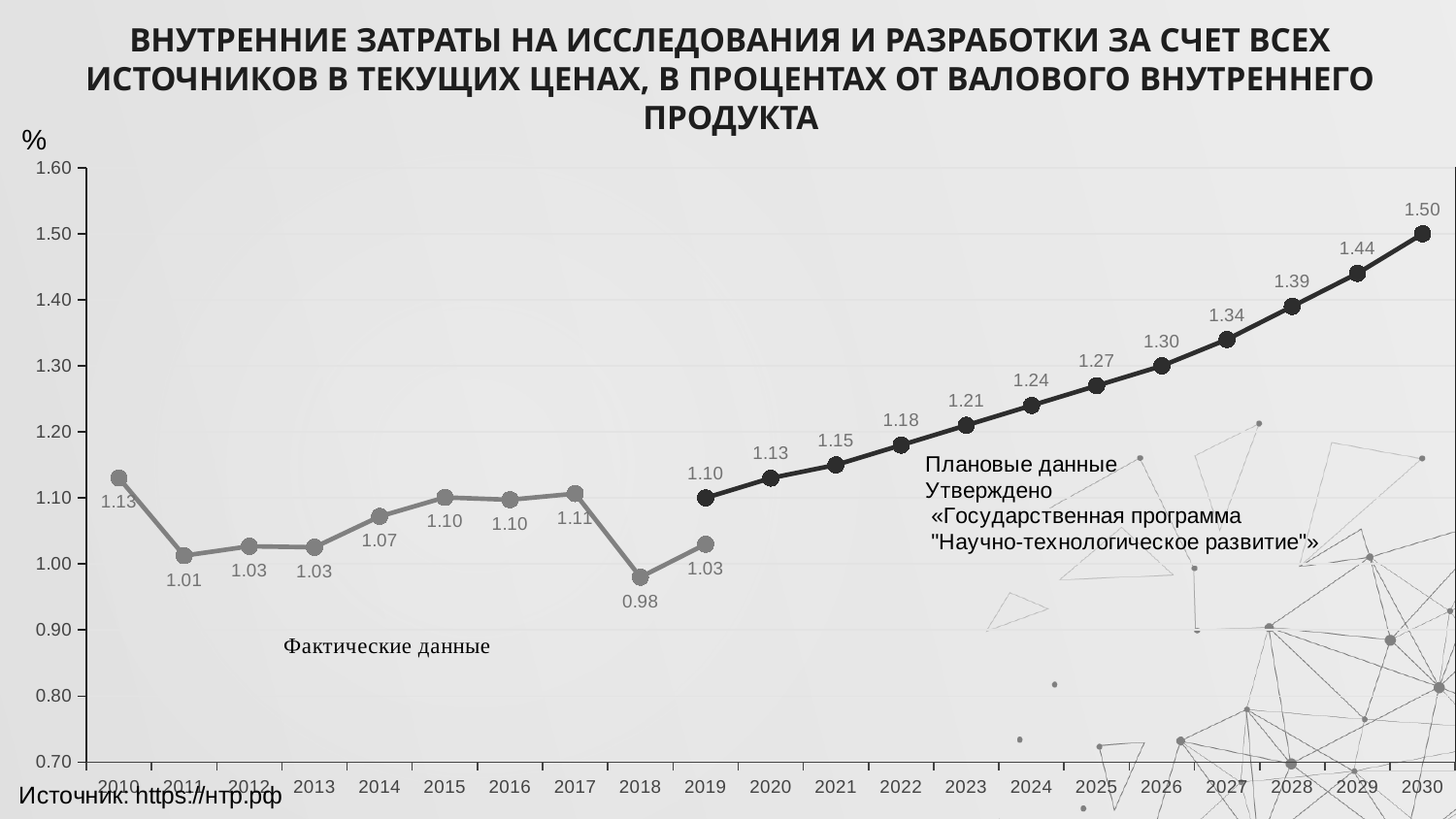
What is the difference between the planned value for 2030 and the value for 2010? 0.37 Which year has the lowest value on the chart? 2018 What type of chart is shown on the slide? line chart What is the value for 2018? 0.98 How many years are shown on the x axis? 21 What unit is shown on the y axis of the chart? % What is the planned value for 2025? 1.27 Which year has the highest value on the chart? 2030 Do the planned values rise or fall from 2019 to 2030? rise Which is larger, the value for 2010 or the value for 2011? 2010 What is the value for 2014? 1.07 What is the planned value for 2030? 1.50